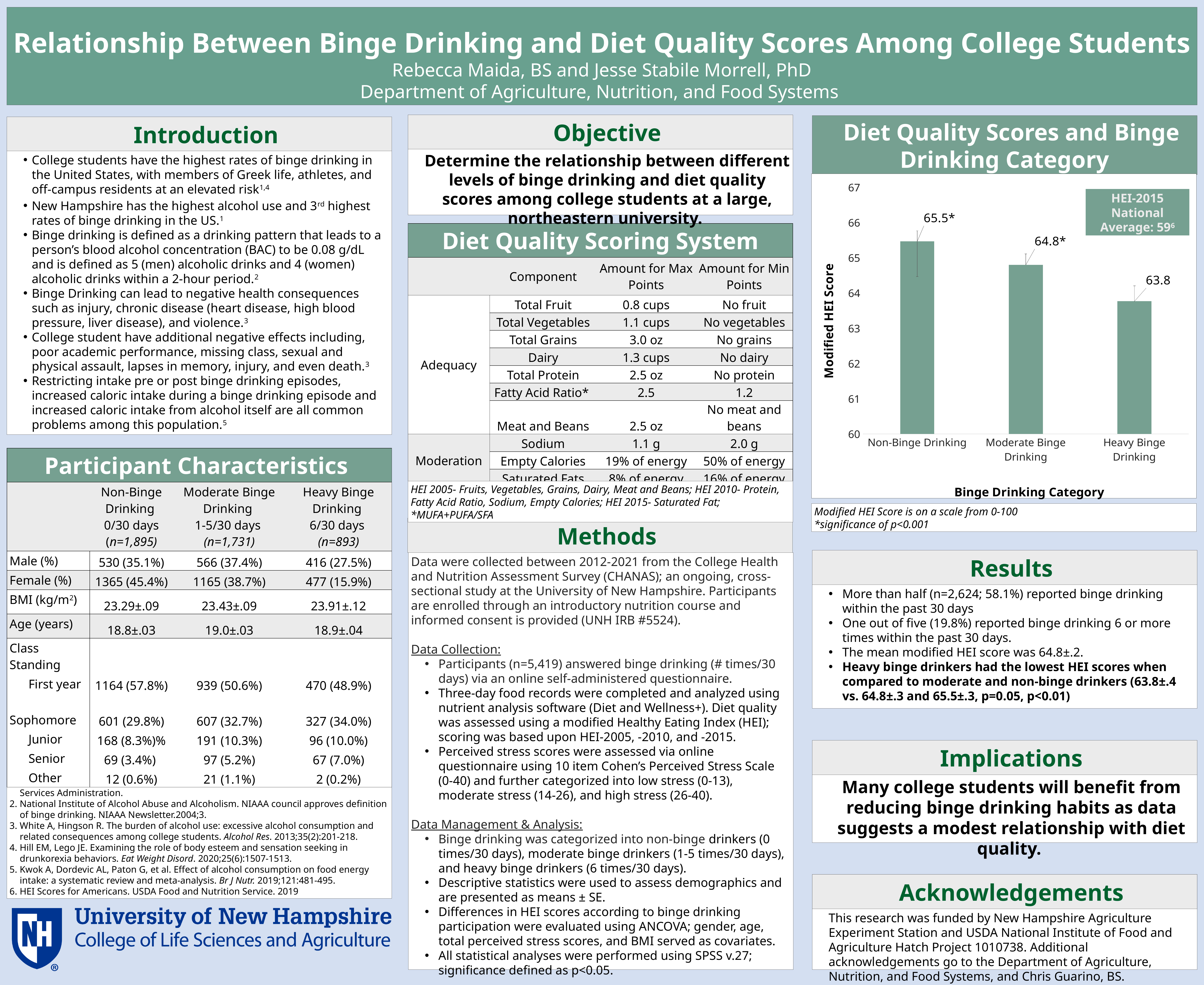
What is the difference between the Modified HEI Scores for Moderate Binge Drinking and Heavy Binge Drinking? 1.0 How many binge drinking categories are shown in the chart? 3 What is the Modified HEI Score for Heavy Binge Drinking? 63.8 What is the Modified HEI Score for Non-Binge Drinking in the Diet Quality Scores and Binge Drinking Category chart? 65.5 What is the difference between the Modified HEI Scores for Non-Binge Drinking and Heavy Binge Drinking? 1.7 Which binge drinking category has the lowest Modified HEI Score? Heavy Binge Drinking What is the label of the y-axis in the Diet Quality Scores and Binge Drinking Category chart? Modified HEI Score Which has a higher Modified HEI Score, Moderate Binge Drinking or Heavy Binge Drinking? Moderate Binge Drinking Do the Modified HEI Scores rise or fall from Non-Binge Drinking to Heavy Binge Drinking? Fall Which binge drinking category has the highest Modified HEI Score? Non-Binge Drinking What is the Modified HEI Score for Moderate Binge Drinking? 64.8 What type of chart is used to show Diet Quality Scores and Binge Drinking Category? Bar chart